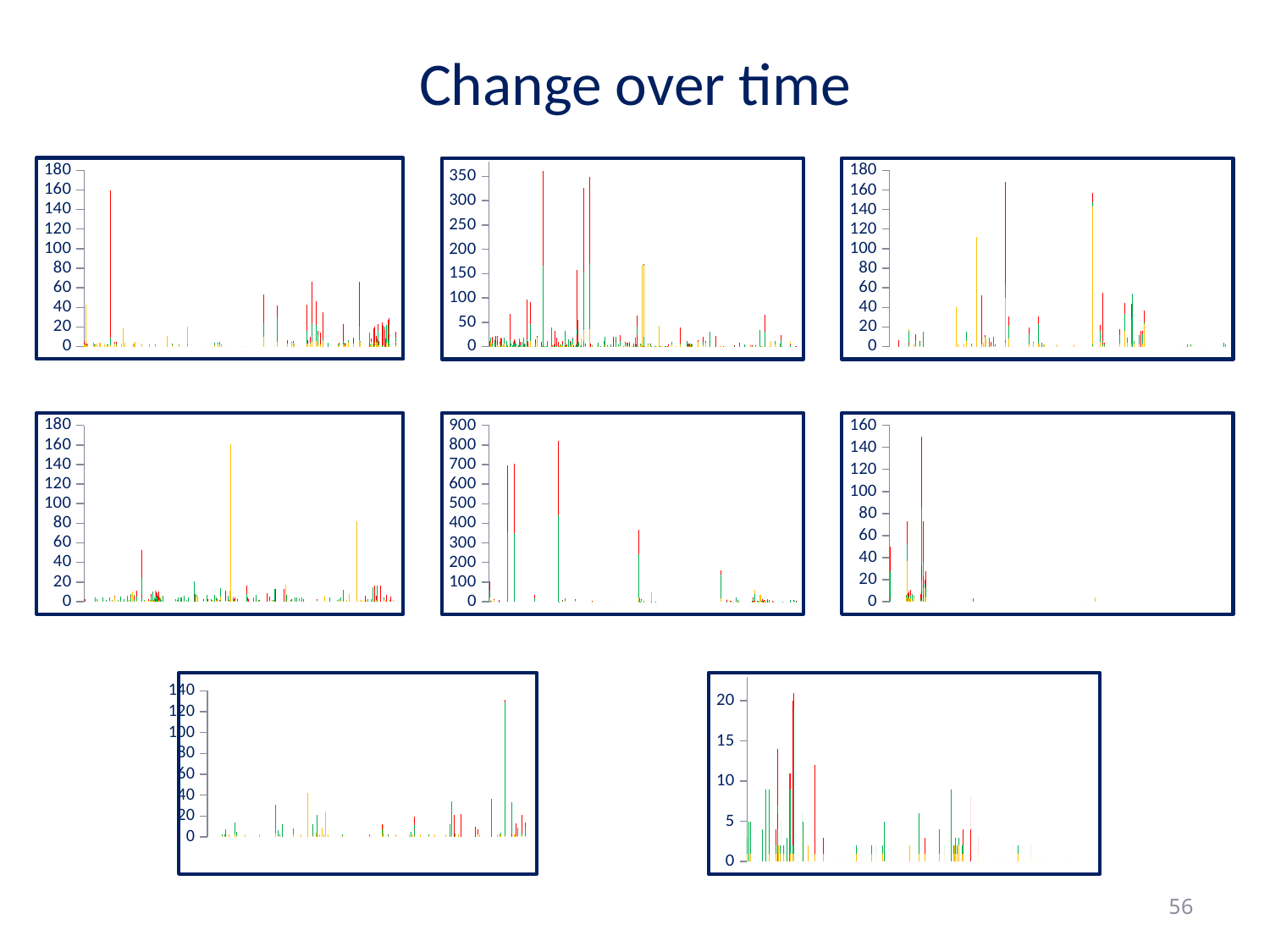
In the top-middle chart, is the tallest bar greater or less than 300? greater In the left chart of the second row, is the tallest bar greater or less than 140? greater In the top-left chart, is the tallest bar greater or less than 140? greater What is the highest value shown on the y axis of the middle chart in the second row? 900 How many charts are shown on the slide? 8 What kind of chart is the top-left chart on the slide? bar chart